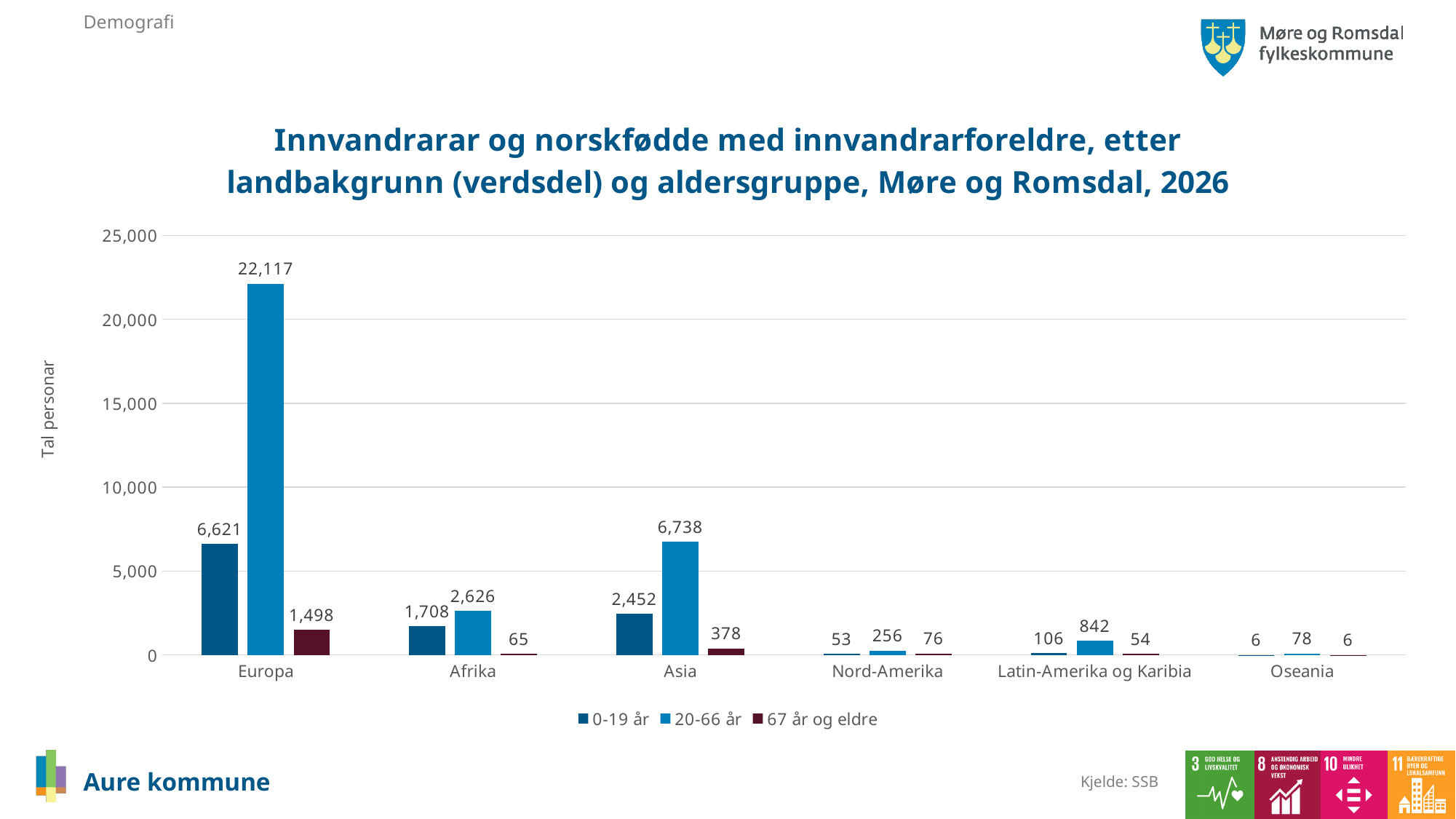
What is the value for the 20-66 år series for Europa? 22,117 Which is larger: the 67 år og eldre value for Nord-Amerika or for Latin-Amerika og Karibia? Nord-Amerika What is the difference between the 20-66 år values for Europa and Asia? 15,379 Which category has the highest value in the 20-66 år series? Europa What is the label of the y axis? Tal personar What is the value for the 0-19 år series for Latin-Amerika og Karibia? 106 How many series does the legend list? 3 How many categories are shown on the x axis? 6 What is the value for the 67 år og eldre series for Asia? 378 What is the difference between the 0-19 år values for Asia and Afrika? 744 What kind of chart is shown on the slide? Bar chart Which category has the lowest value in the 0-19 år series? Oseania